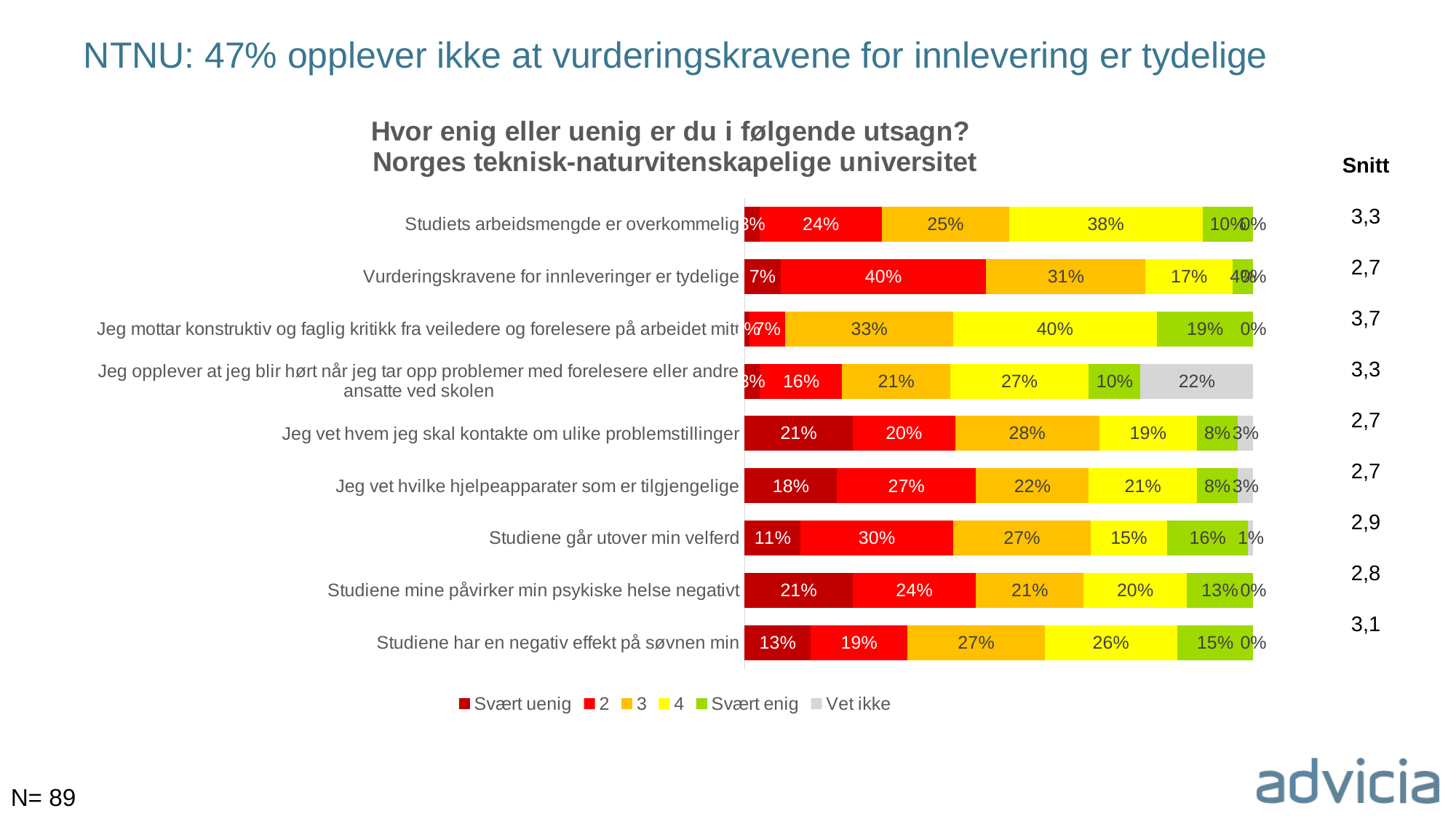
What is the first entry in the chart legend? Svært uenig Which has the larger "Svært enig" value: "Studiene går utover min velferd" or "Studiene mine påvirker min psykiske helse negativt"? Studiene går utover min velferd What kind of chart is shown on the slide? Stacked bar chart How many statements (categories) are plotted in the chart? 9 What is the value of series "4" for "Jeg mottar konstruktiv og faglig kritikk fra veiledere og forelesere på arbeidet mitt"? 40% For "Studiene går utover min velferd", what is the difference between the value of series "2" and the "Svært uenig" value? 19 percentage points How many series does the chart legend list? 6 What is the value of series "2" for "Vurderingskravene for innleveringer er tydelige"? 40% Which statement has the highest value for series "4"? Jeg mottar konstruktiv og faglig kritikk fra veiledere og forelesere på arbeidet mitt What is the "Vet ikke" value for "Jeg opplever at jeg blir hørt når jeg tar opp problemer med forelesere eller andre ansatte ved skolen"? 22% What is the "Svært uenig" value for "Jeg vet hvem jeg skal kontakte om ulike problemstillinger"? 21% Which statement has the highest "Vet ikke" share? Jeg opplever at jeg blir hørt når jeg tar opp problemer med forelesere eller andre ansatte ved skolen